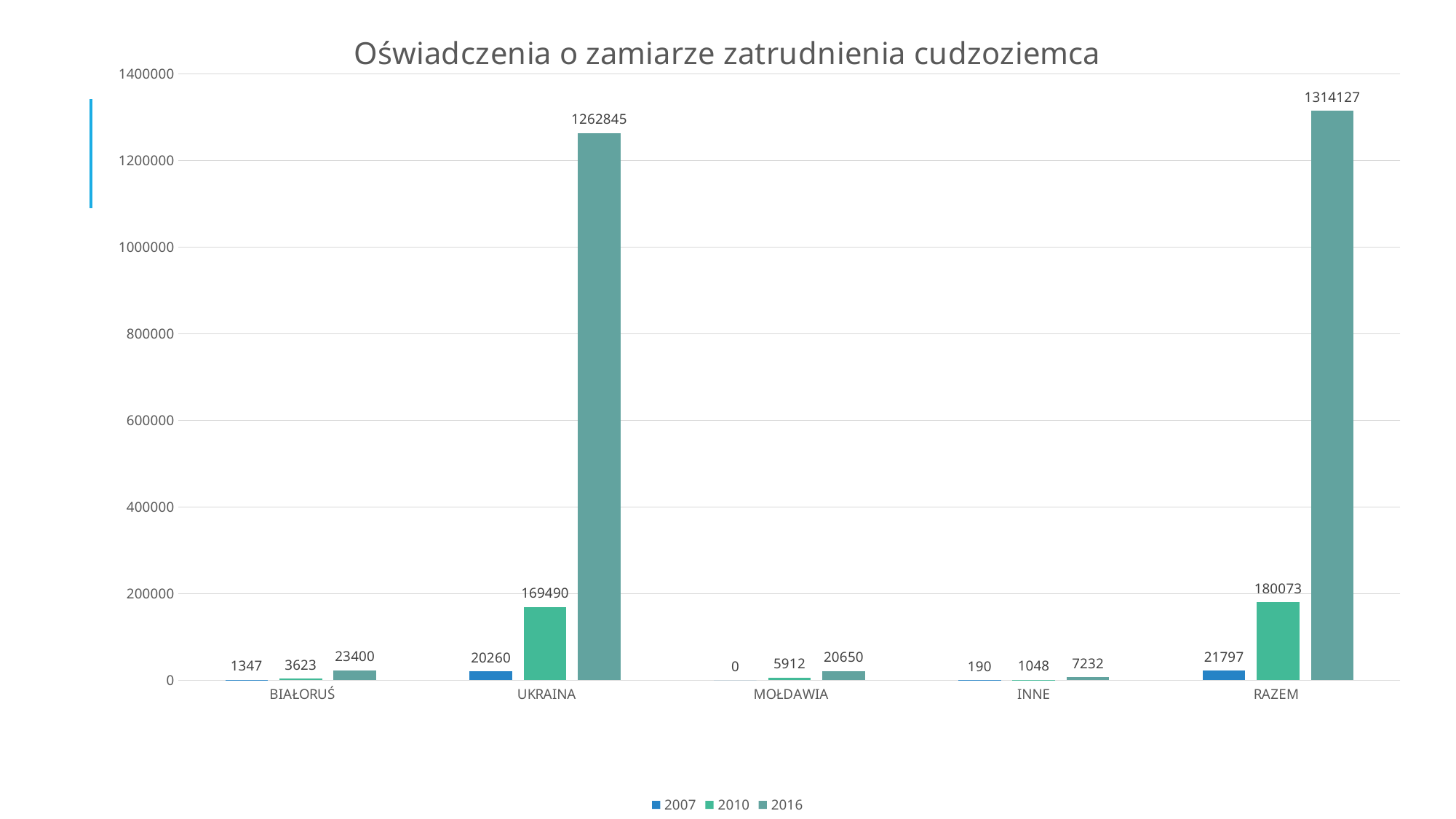
How many series does the legend list? 3 Which category has the highest value in the 2016 series? RAZEM Which is larger: the 2010 value for BIAŁORUŚ or the 2010 value for MOŁDAWIA? MOŁDAWIA Which category has the lowest value in the 2007 series? MOŁDAWIA How many categories are shown on the x axis? 5 What is the value for INNE in 2016? 7232 What is the title of the chart? Oświadczenia o zamiarze zatrudnienia cudzoziemca What kind of chart is shown on the slide? bar chart What is the value for MOŁDAWIA in 2010? 5912 What is the value for BIAŁORUŚ in 2007? 1347 What is the difference between the 2016 and 2010 values for UKRAINA? 1093355 What is the value for UKRAINA in 2016? 1262845